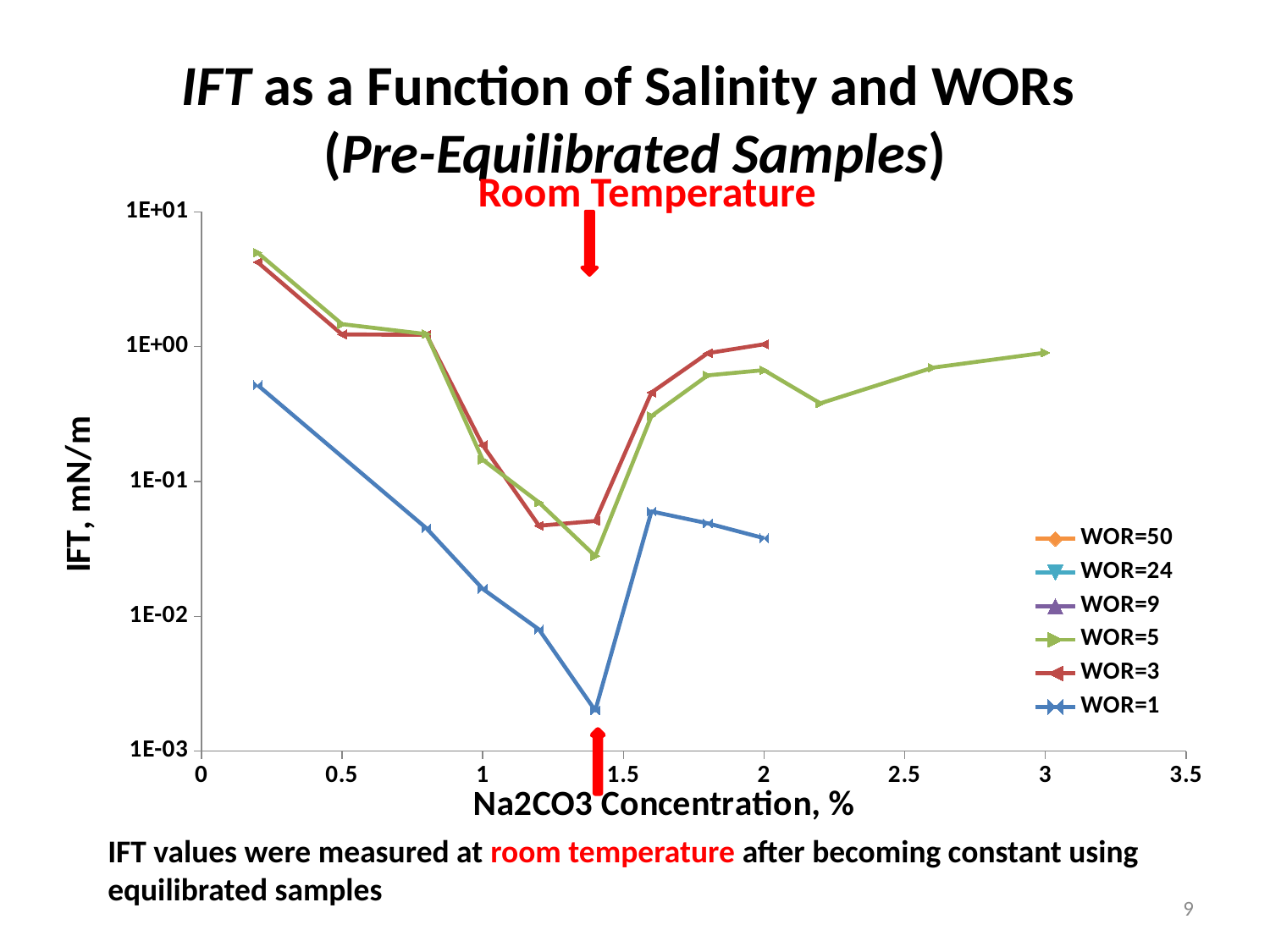
Which series extends to the highest Na2CO3 concentration on the x axis? WOR=5 Is the lowest value of the WOR=1 series greater or less than 1E-02? less What kind of chart is shown on the slide? line chart Is the value for WOR=5 at a Na2CO3 concentration of 0.2% greater or less than 1E+00? greater Which series reaches the lowest IFT value on the chart? WOR=1 What is the title of the x axis? Na2CO3 Concentration, % At a Na2CO3 concentration of 0.2%, which series has the larger IFT value, WOR=5 or WOR=1? WOR=5 Does the WOR=1 series rise or fall as Na2CO3 concentration increases from 0.2% to about 1.4%? fall Is the value for WOR=1 at a Na2CO3 concentration of 0.2% greater or less than 1E+00? less What is the title of the y axis? IFT, mN/m How many series does the legend list? 6